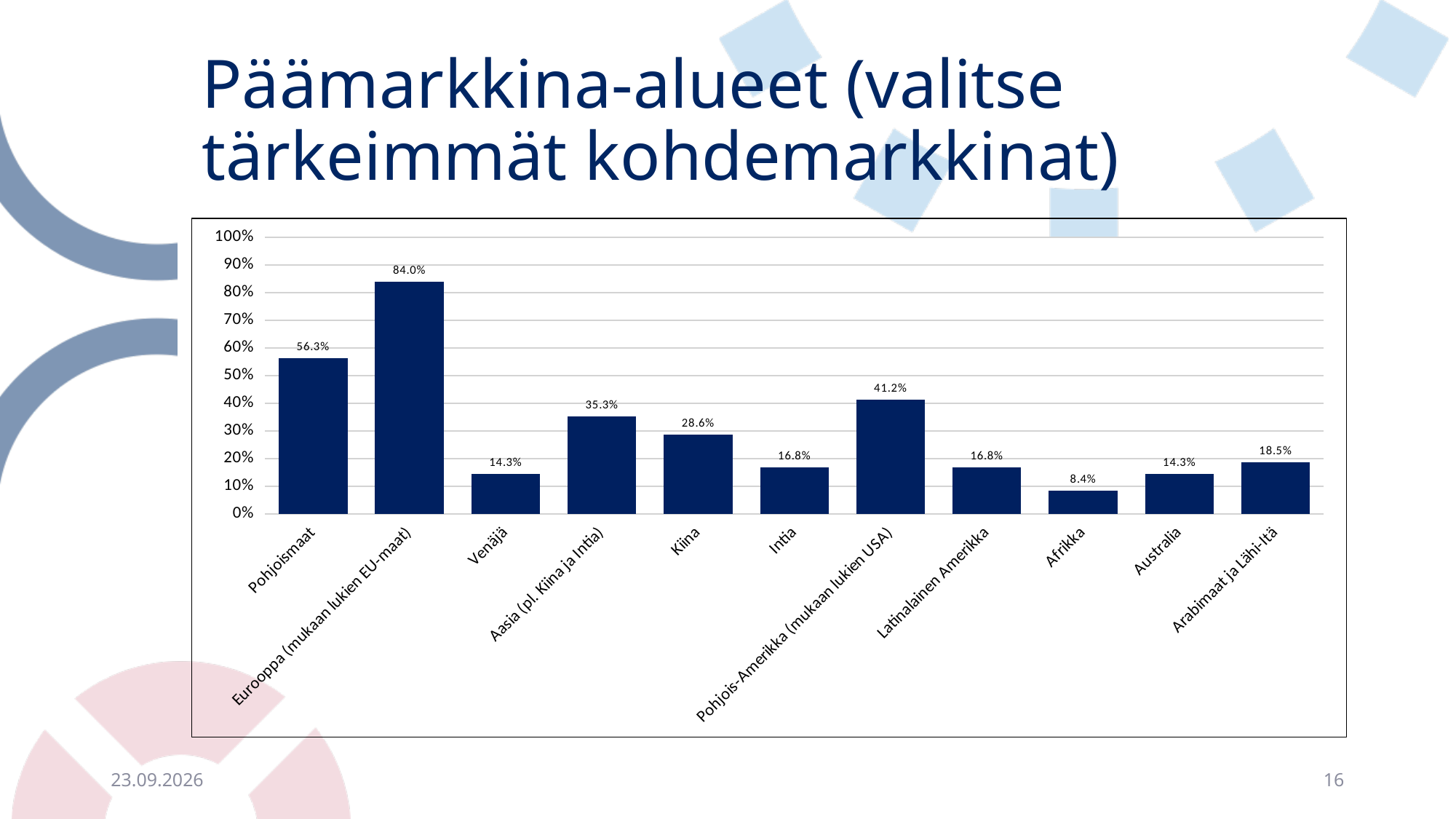
What is the difference between the values for Eurooppa (mukaan lukien EU-maat) and Pohjoismaat? 27.7% Which is larger, the value for Aasia (pl. Kiina ja Intia) or the value for Pohjois-Amerikka (mukaan lukien USA)? Pohjois-Amerikka (mukaan lukien USA) What is the value for Kiina? 28.6% Which category has the highest value? Eurooppa (mukaan lukien EU-maat) What is the value for Arabimaat ja Lähi-Itä? 18.5% What kind of chart is shown on the slide? bar chart What is the value for Eurooppa (mukaan lukien EU-maat)? 84.0% Is the value for Kiina greater or less than 20%? greater How many categories are shown on the x axis? 11 What is the difference between the values for Intia and Afrikka? 8.4% Which category has the lowest value? Afrikka What is the value for Pohjoismaat? 56.3%